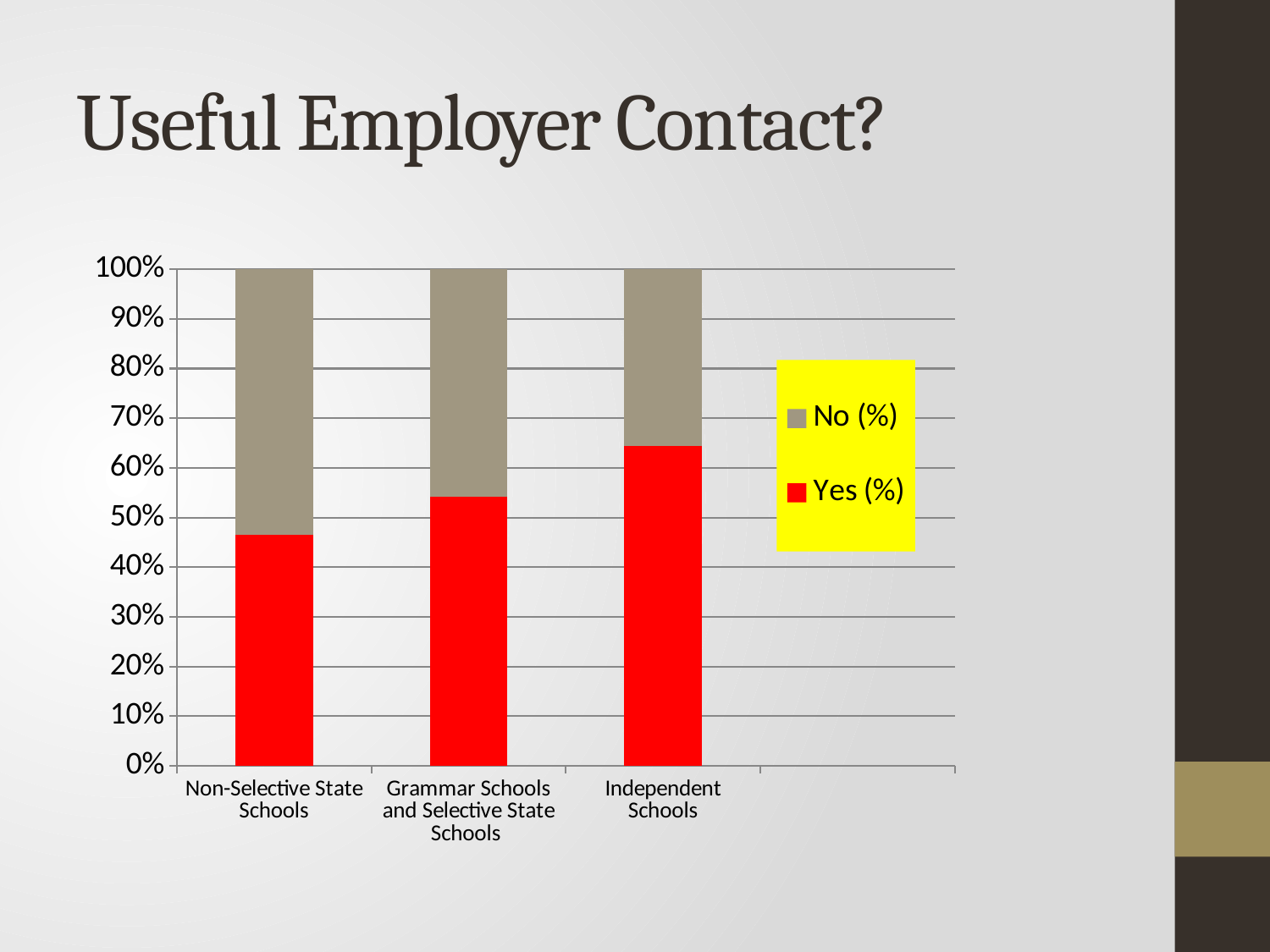
Which is larger, the Yes (%) value for Grammar Schools and Selective State Schools or for Independent Schools? Independent Schools Which category has the largest No (%) share? Non-Selective State Schools Which category has the highest Yes (%) value? Independent Schools What is the title of the chart? Useful Employer Contact? Which category has the lowest Yes (%) value? Non-Selective State Schools How many school categories are shown on the x axis? 3 Is the Yes (%) value for Independent Schools greater or less than 60%? greater Is the Yes (%) value for Non-Selective State Schools greater or less than 50%? less Is the No (%) value for Grammar Schools and Selective State Schools greater or less than 50%? less Does the Yes (%) value rise or fall moving from left to right across the categories? rise What kind of chart is shown on the slide? stacked bar chart How many series does the legend list? 2